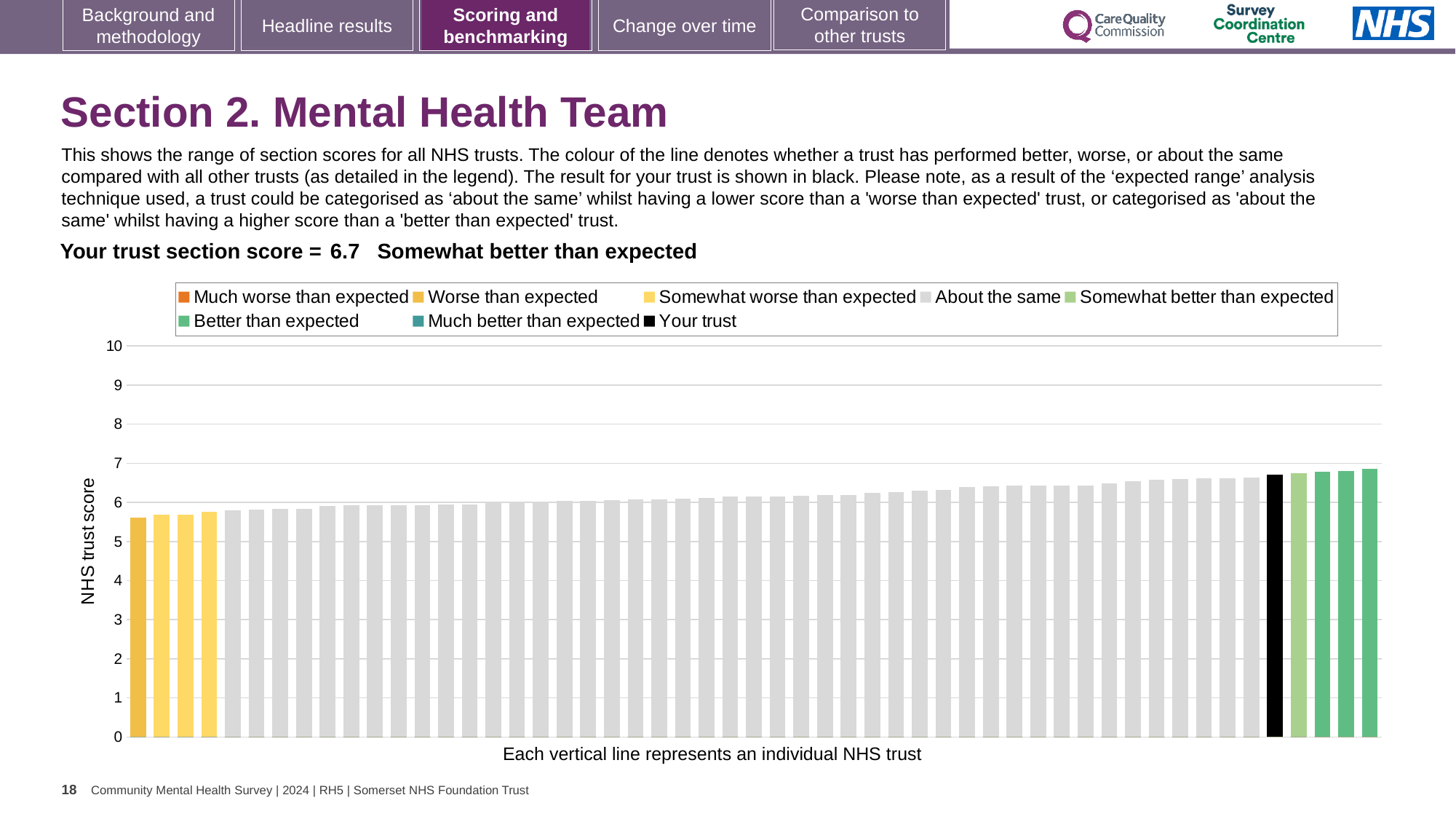
What is the section score for your trust shown on the slide? 6.7 Which is larger, the black 'Your trust' bar or the leftmost bar? the black 'Your trust' bar How many bars are coloured in the 'Worse than expected' / 'Somewhat worse than expected' yellow shades? 4 How many entries does the chart legend list? 8 Do the bar values rise or fall from left to right along the x axis? rise Is the value of the leftmost bar greater or less than 6? less Which category does your trust's section score fall into according to the slide? Somewhat better than expected Is the value of the black 'Your trust' bar greater or less than 6? greater What is the label on the y axis of the chart? NHS trust score What kind of chart is shown on the slide? bar chart Is the value of the black 'Your trust' bar greater or less than 7? less